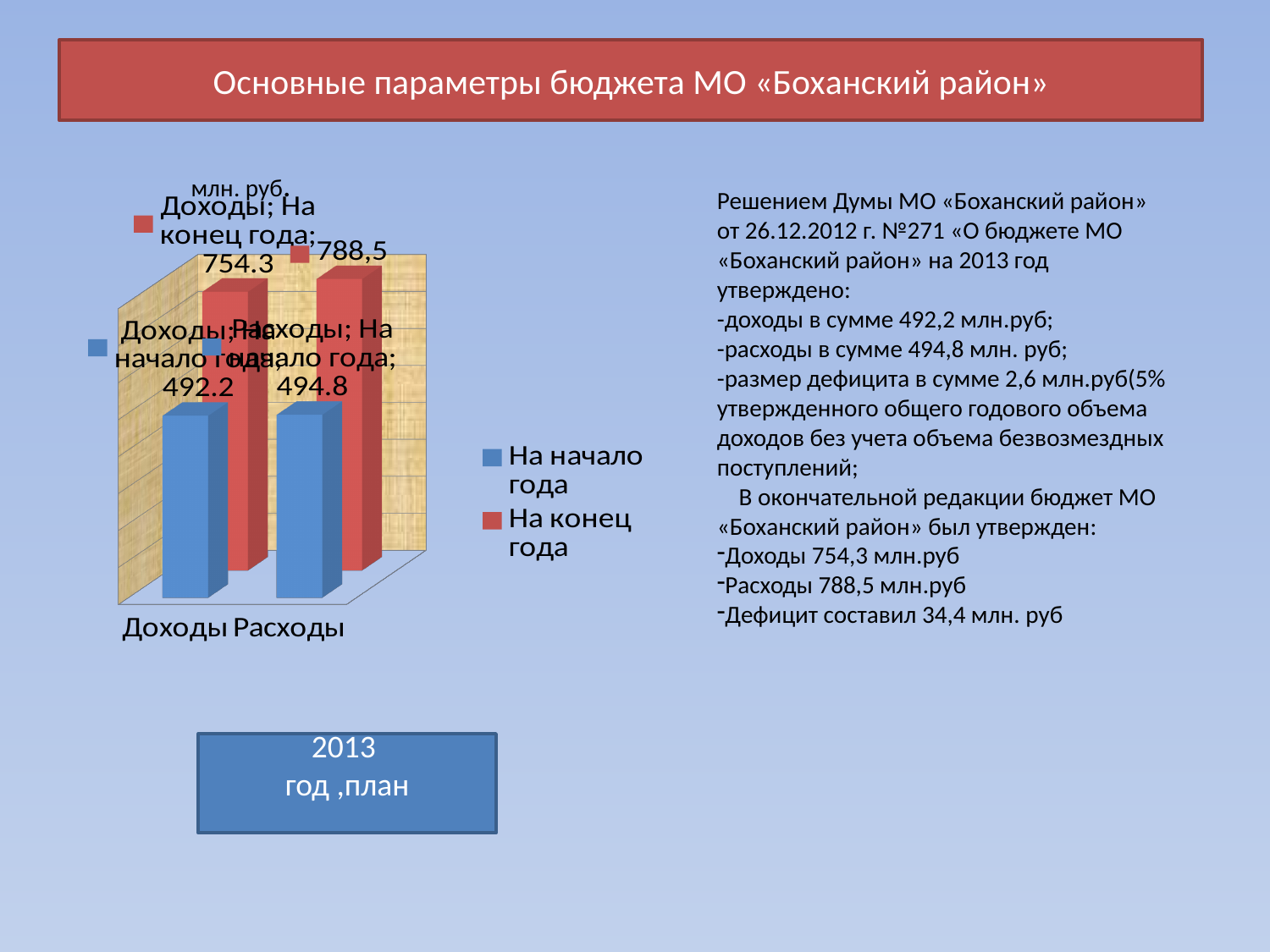
What is the value for Расходы in the На конец года series? 788,5 How many categories are shown on the chart? 2 How many series does the legend list? 2 What is the difference between the На конец года and На начало года values for Доходы? 262.1 What is the difference between Расходы and Доходы in the На начало года series? 2.6 Which category has the lowest value in the На начало года series? Доходы Which category has the highest value in the На конец года series? Расходы What is the value for Расходы in the На начало года series? 494.8 Which is larger for Расходы: the На начало года value or the На конец года value? На конец года What is the value for Доходы in the На конец года series? 754.3 What kind of chart is shown on the slide? Bar chart What is the value for Доходы in the На начало года series? 492.2